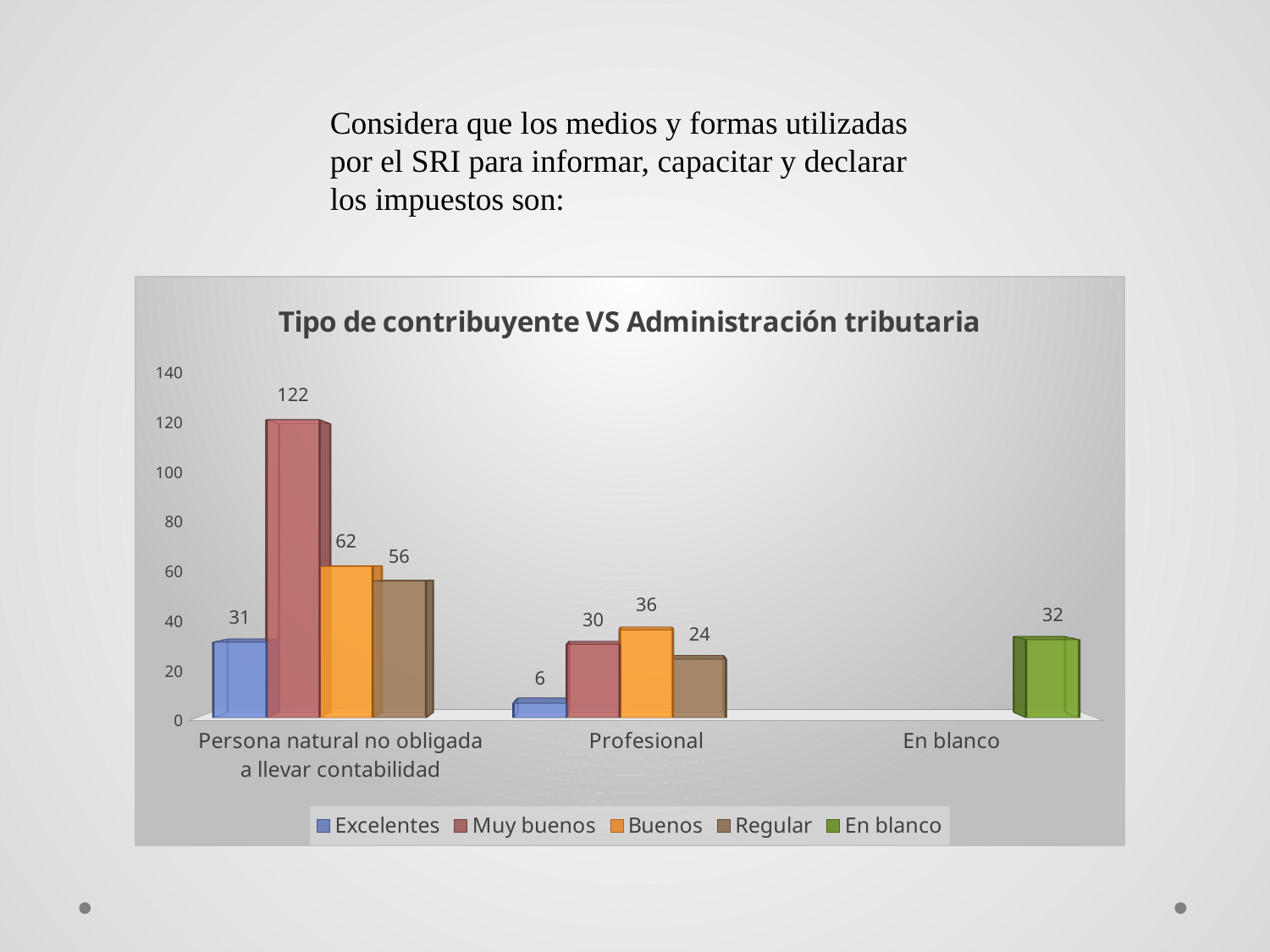
What is the value for En blanco in the En blanco category? 32 What is the title of the chart? Tipo de contribuyente VS Administración tributaria What is the value for Regular in the Profesional category? 24 How many categories are shown on the x axis? 3 What is the value for Excelentes in the Profesional category? 6 What is the difference between Buenos and Regular in the Persona natural no obligada a llevar contabilidad category? 6 How many series does the legend list? 5 What is the value for Muy buenos in the Persona natural no obligada a llevar contabilidad category? 122 Which is larger: Buenos for Profesional or Excelentes for Persona natural no obligada a llevar contabilidad? Buenos for Profesional Is the value for Muy buenos in the Persona natural no obligada a llevar contabilidad category greater or less than 100? greater Which series has the lowest value in the Profesional category? Excelentes Which series has the highest value in the Persona natural no obligada a llevar contabilidad category? Muy buenos